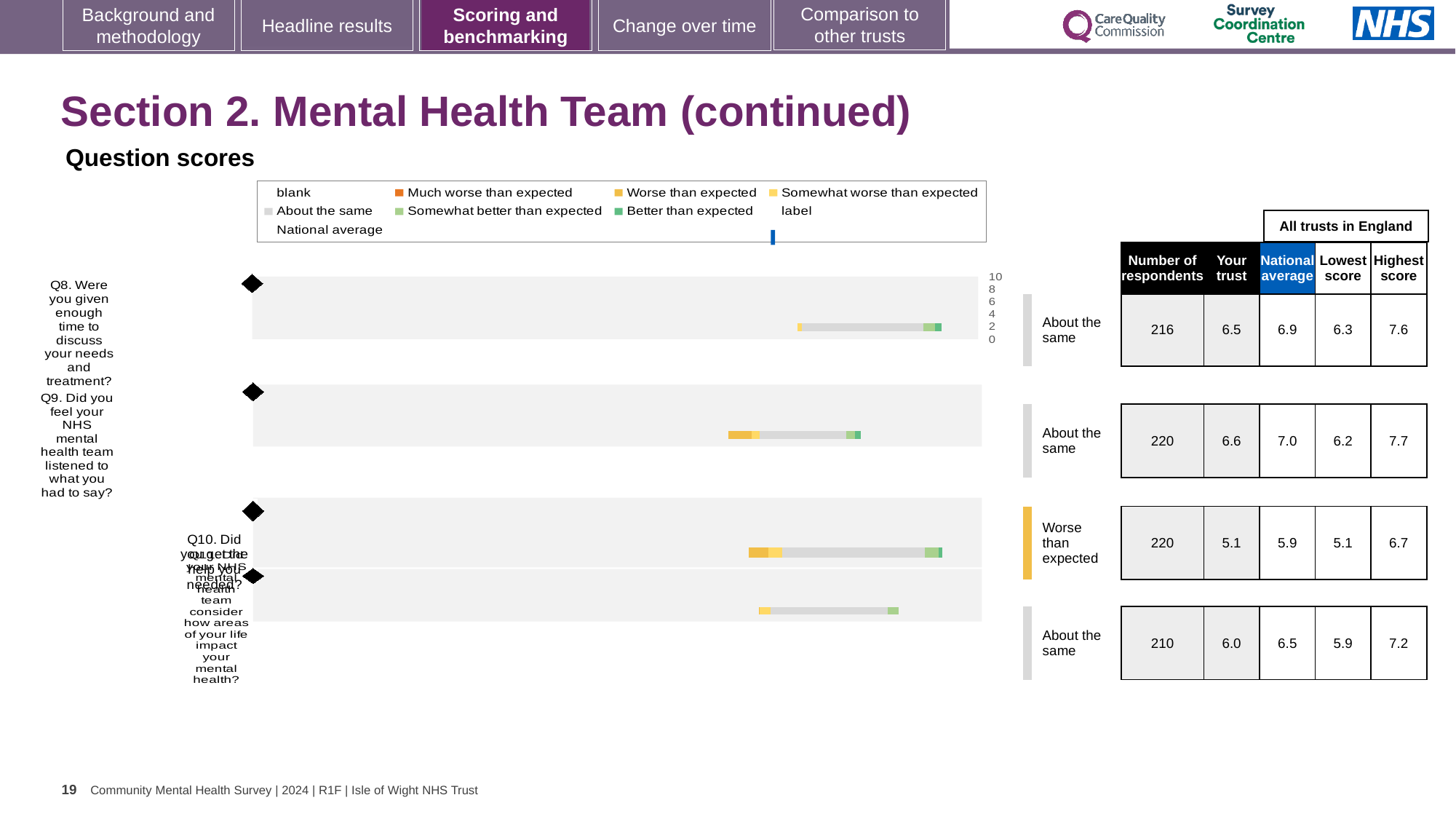
For Q8, which is larger: the 'Your trust' score or the national average? National average Which question has the highest 'Your trust' score? Q9 What is the 'Your trust' score for Q8 (Were you given enough time to discuss your needs and treatment?)? 6.5 What kind of chart is used to show the question scores on this slide? bar chart What is the lowest score across all trusts in England for Q10? 5.1 For Q10, what is the difference between the national average and the 'Your trust' score? 0.8 How many respondents answered Q10 (Did you get the help you needed?)? 220 What benchmark category is shown for Q10 (Did you get the help you needed?)? Worse than expected What is the national average score for Q9 (Did you feel your NHS mental health team listened to what you had to say?)? 7.0 How many question rows (bars) are plotted in the question scores chart? 4 What is the highest score across all trusts in England for the fourth (bottom) question row? 7.2 Which question has the lowest 'Your trust' score? Q10